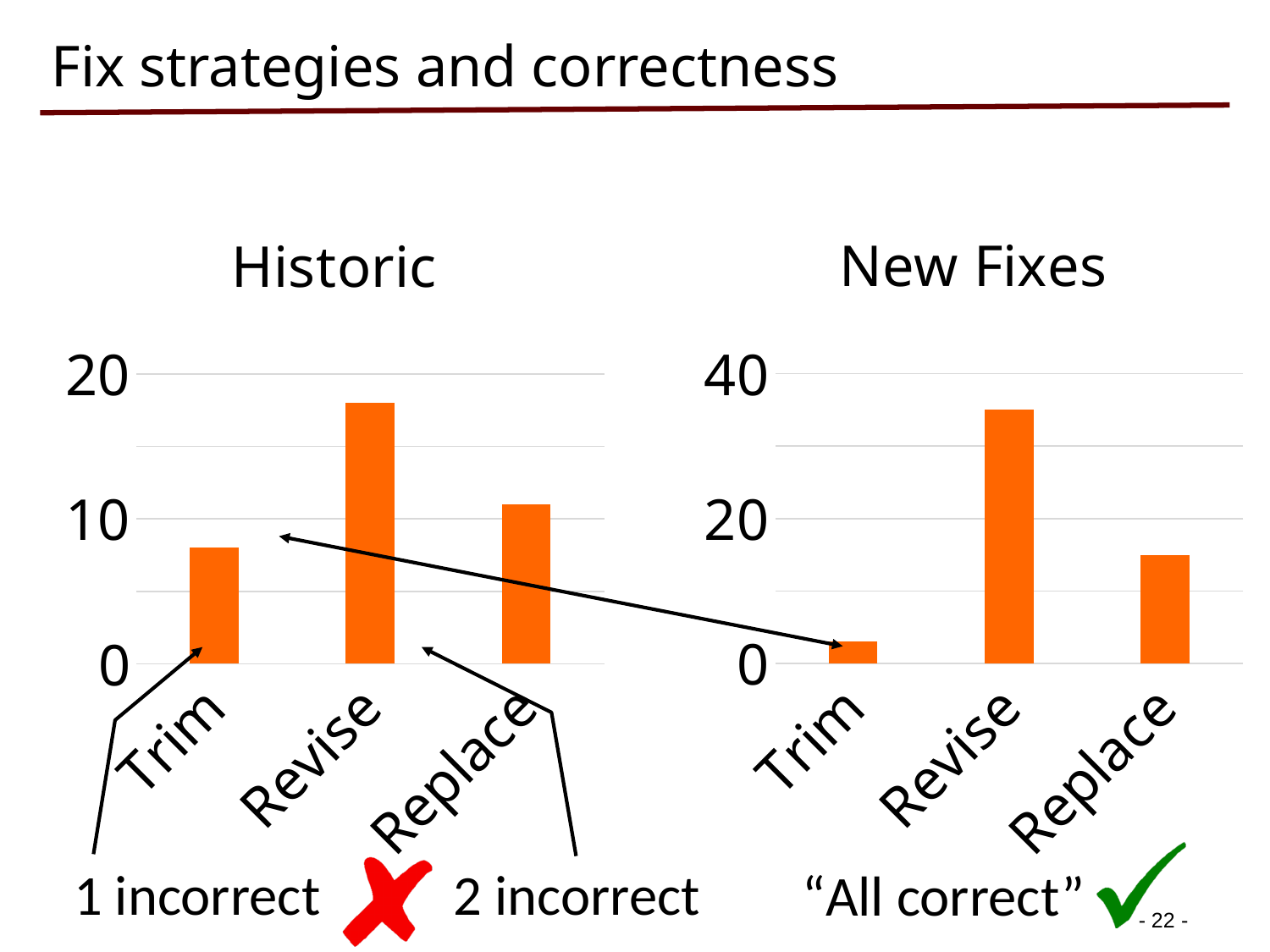
How many categories are shown on the x axis of the New Fixes chart? 3 In the Historic chart, which category has the lowest bar? Trim In the Historic chart, is the value for Revise greater or less than 10? greater In the New Fixes chart, which category has the lowest bar? Trim What is the title of the chart on the right side of the slide? New Fixes In the Historic chart, is the value for Trim greater or less than 10? less In the Historic chart, which is larger, the value for Replace or the value for Trim? Replace In the Historic chart, which category has the highest bar? Revise In the New Fixes chart, is the value for Replace greater or less than 20? less What type of chart is the Historic chart? bar chart In the New Fixes chart, which category has the highest bar? Revise